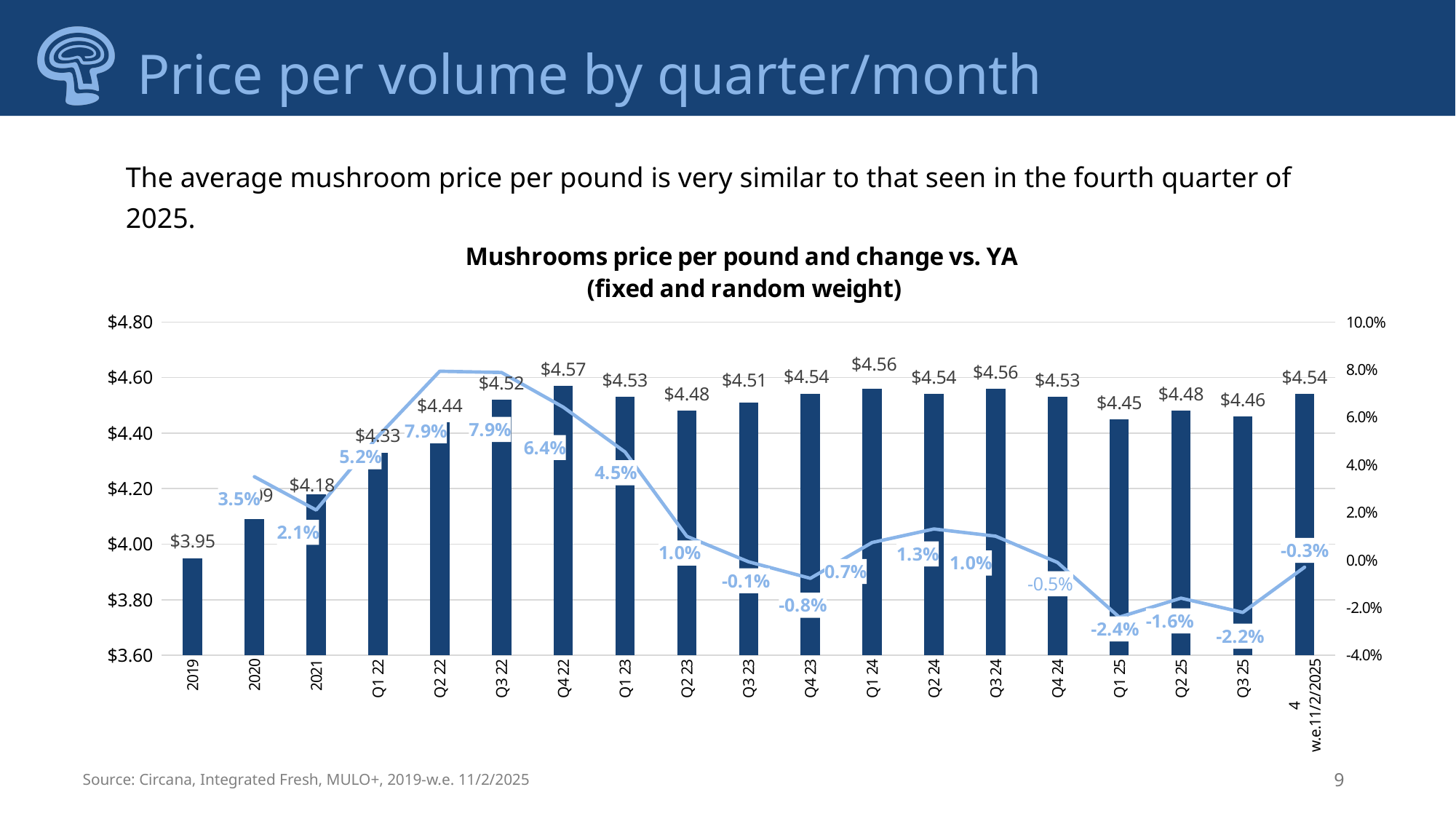
What is the change vs. YA shown for Q2 22? 7.9% What kind of chart is used to show the price per pound and change vs. YA? A bar chart combined with a line What is the difference between the price per pound in Q4 22 and in 2019? $0.62 Which period has the lowest price per pound? 2019 How many periods are shown on the x axis? 19 What is the change vs. YA shown for Q1 25? -2.4% Which has the higher price per pound, Q1 24 or Q4 24? Q1 24 Is the price per pound for 2019 greater or less than $4.00? less What is the price per pound for the 4 w.e. 11/2/2025 period? $4.54 What is the mushroom price per pound for Q4 22? $4.57 Which period has the highest price per pound? Q4 22 Which period has the lowest change vs. YA on the line? Q1 25